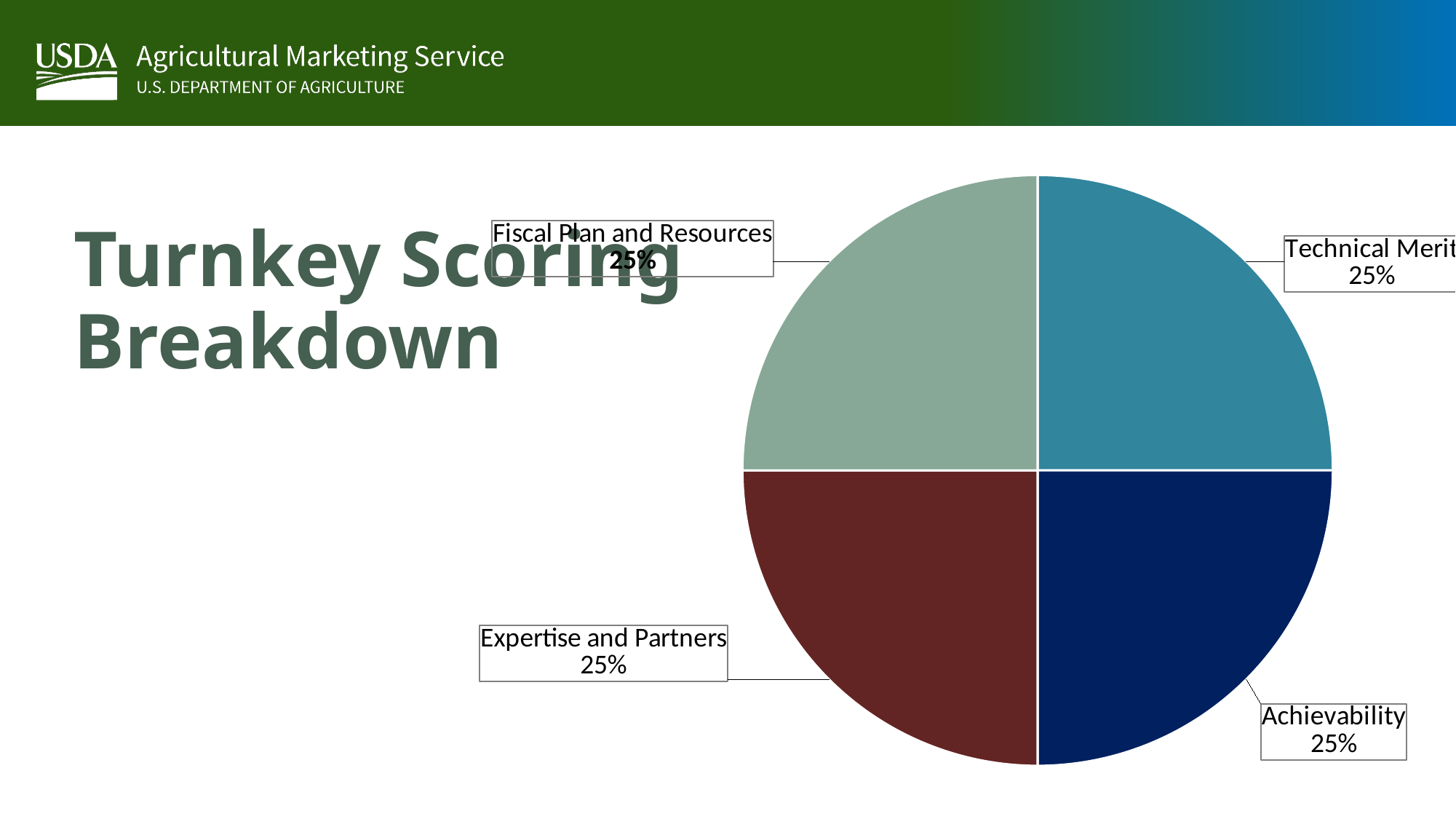
Which slice of the pie is dark navy blue? Achievability Which slice of the pie is dark red? Expertise and Partners What is the value shown for Achievability? 25% What share of the pie does Technical Merit represent? 25% Is the value for Expertise and Partners greater or less than 50%? less What is the combined share of Technical Merit and Achievability? 50% How many slices does the pie chart have? 4 What is the value shown for Expertise and Partners? 25% What is the difference between the values for Technical Merit and Achievability? 0% What is the value shown for Fiscal Plan and Resources? 25% What kind of chart is shown on the slide? pie chart